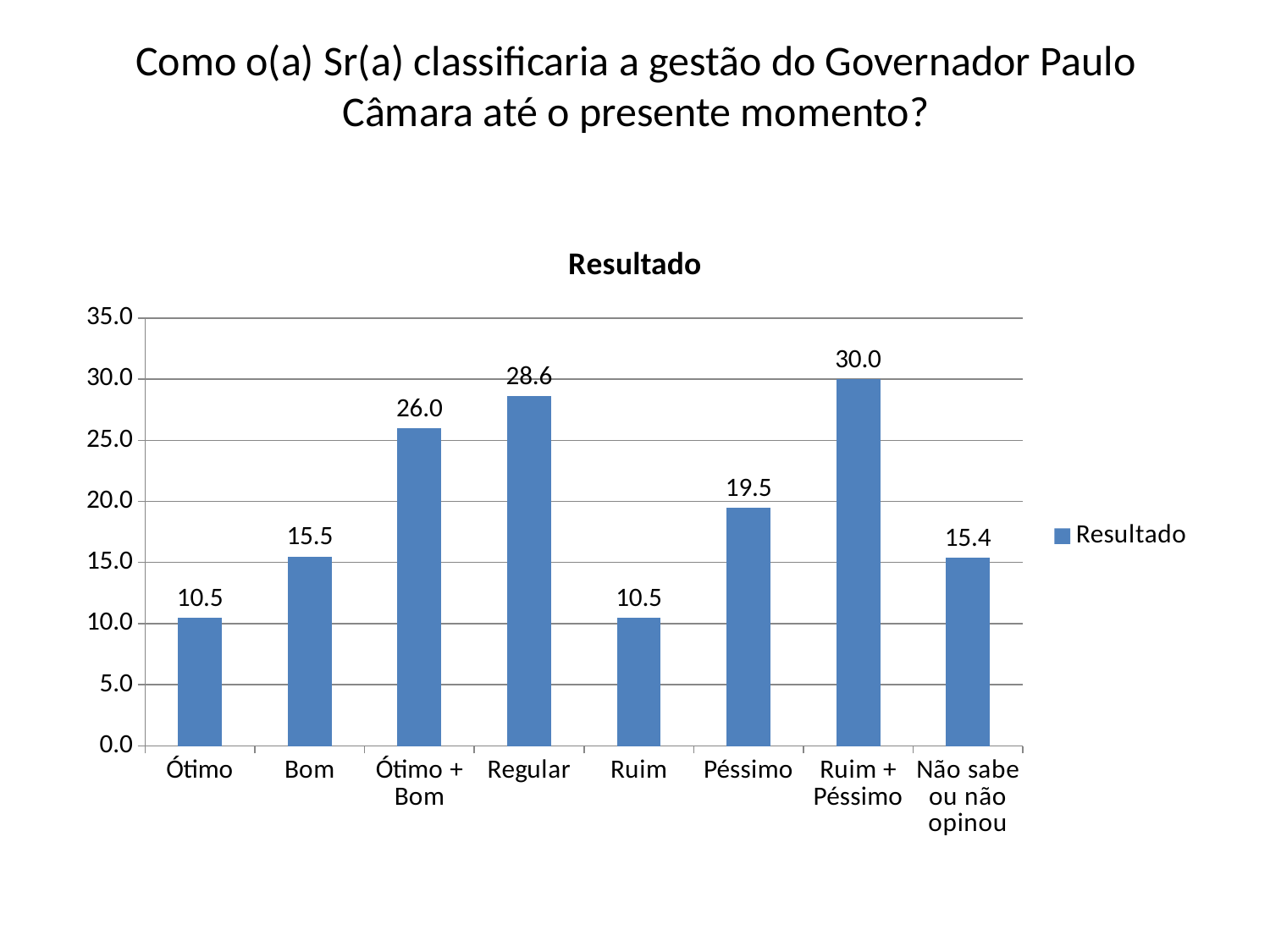
What is the value for Ótimo + Bom? 26.0 Is the value for Regular greater or less than 25.0? greater Which is larger, the value for Bom or the value for Péssimo? Péssimo Which category has the highest value? Ruim + Péssimo What is the title of the chart? Resultado What is the value for Não sabe ou não opinou? 15.4 What is the difference between the values for Ruim + Péssimo and Ótimo + Bom? 4.0 How many categories are shown on the x axis? 8 How many series does the legend list? 1 What kind of chart is shown? bar chart What is the value for Regular? 28.6 What is the difference between the values for Péssimo and Ruim? 9.0